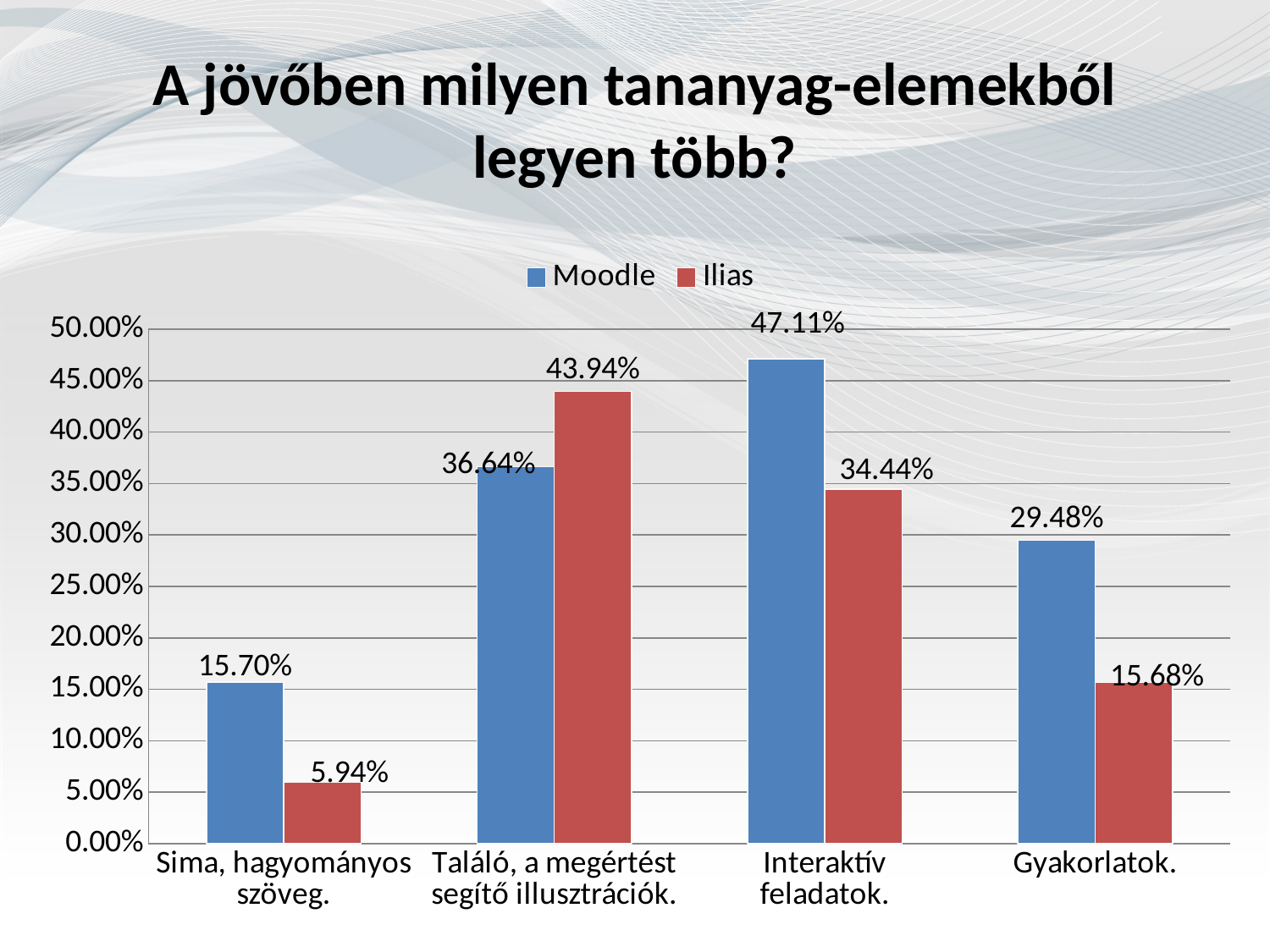
What is the Moodle value for Interaktív feladatok? 47.11% Which category has the lowest Ilias value? Sima, hagyományos szöveg. How many series does the legend list? 2 What is the difference between the Ilias and Moodle values for Találó, a megértést segítő illusztrációk? 7.30% How many categories are shown on the x axis? 4 What is the Moodle value for Gyakorlatok? 29.48% What is the Ilias value for Sima, hagyományos szöveg? 5.94% Which category has the highest Moodle value? Interaktív feladatok. For Gyakorlatok, which series has the larger value, Moodle or Ilias? Moodle What is the Ilias value for Találó, a megértést segítő illusztrációk? 43.94% What kind of chart is shown on the slide? Bar chart What is the difference between the Moodle and Ilias values for Interaktív feladatok? 12.67%